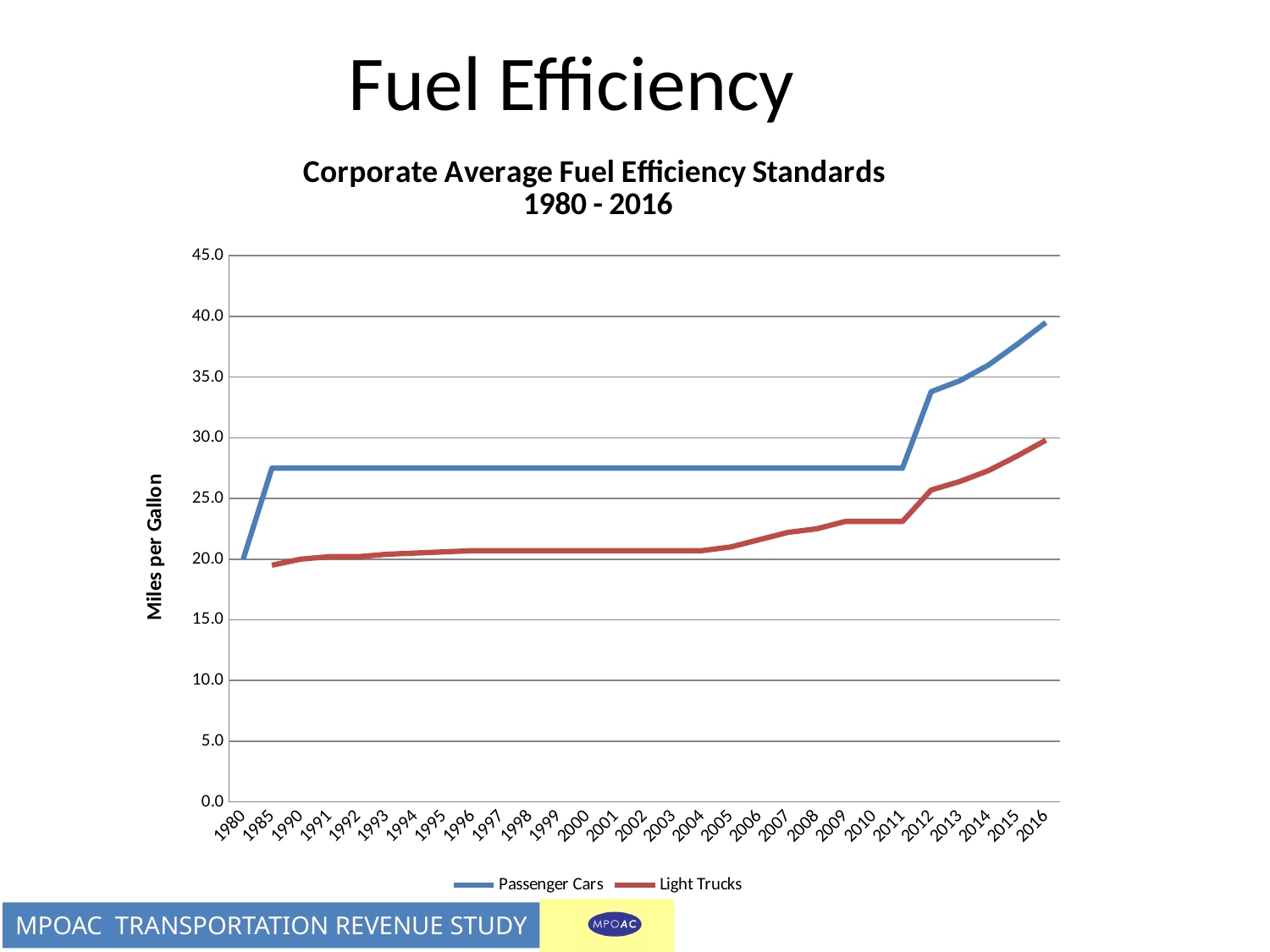
How many series does the legend list? 2 What is the value for Passenger Cars in 1980? 20.0 Is the value for Passenger Cars in 2016 greater or less than 35.0? greater What is the label of the vertical axis? Miles per Gallon What are the two series named in the legend? Passenger Cars and Light Trucks Is the value for Passenger Cars in 2000 greater or less than 25.0? greater Is the value for Light Trucks in 2009 greater or less than 20.0? greater What kind of chart is shown on the slide? line chart How many years are shown along the x axis? 29 In which year does the Passenger Cars series reach its highest value? 2016 In 2010, which series has the higher value, Passenger Cars or Light Trucks? Passenger Cars